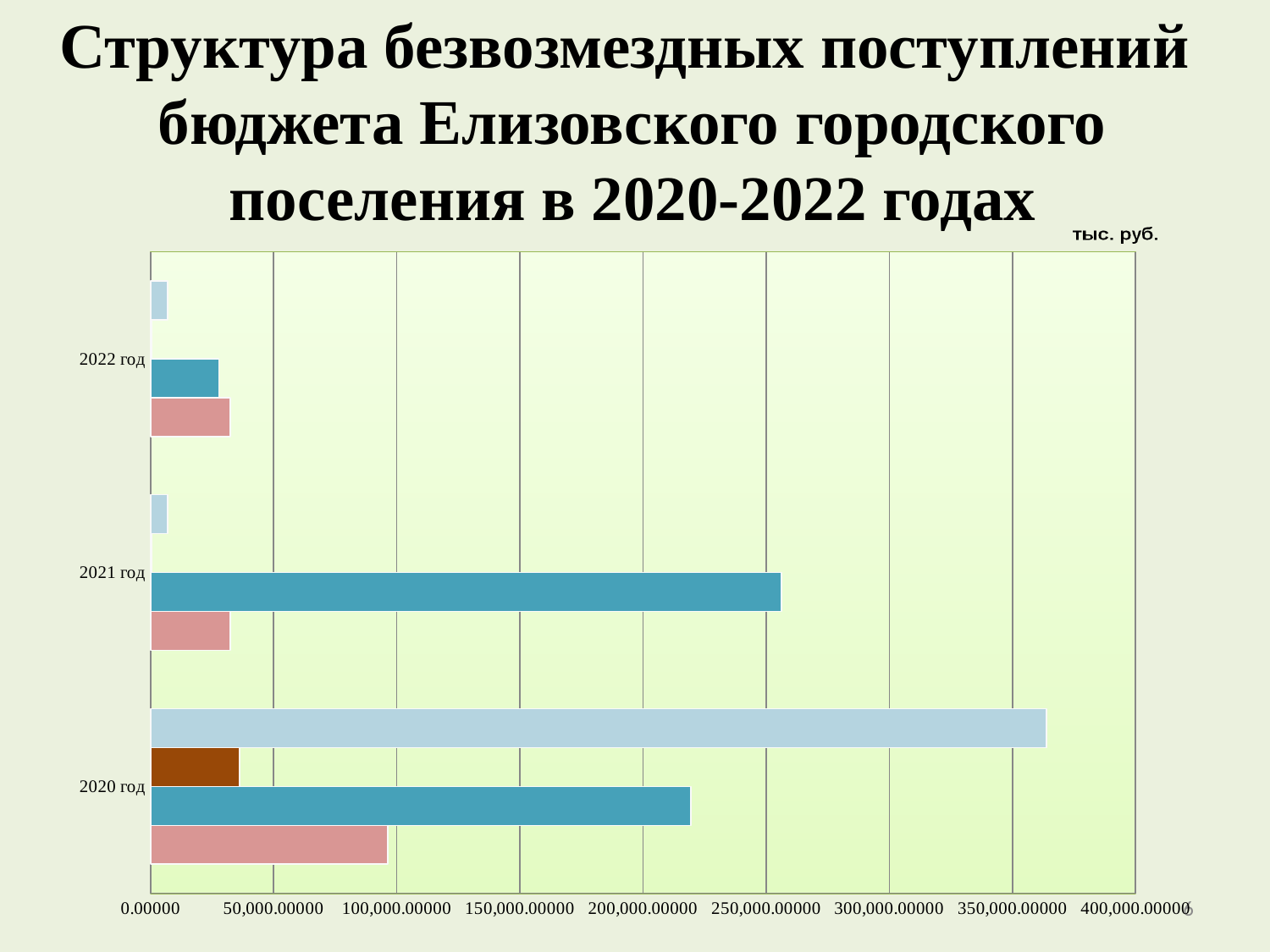
What kind of chart is shown on the slide? bar chart Is the value of the light blue bar for 2020 год greater or less than 350,000.00000? greater How many year categories are shown on the vertical axis of the chart? 3 Is the value of the teal bar for 2020 год greater or less than 250,000.00000? less Which year category contains the longest bar in the chart? 2020 год Is the value of the teal bar for 2021 год greater or less than 200,000.00000? greater For 2020 год, which bar is longer: the teal bar or the pink bar? the teal bar What is the title of the chart on the slide? Структура безвозмездных поступлений бюджета Елизовского городского поселения в 2020-2022 годах Is the teal bar longer for 2021 год or for 2022 год? 2021 год What unit label is shown above the chart's horizontal axis? тыс. руб.